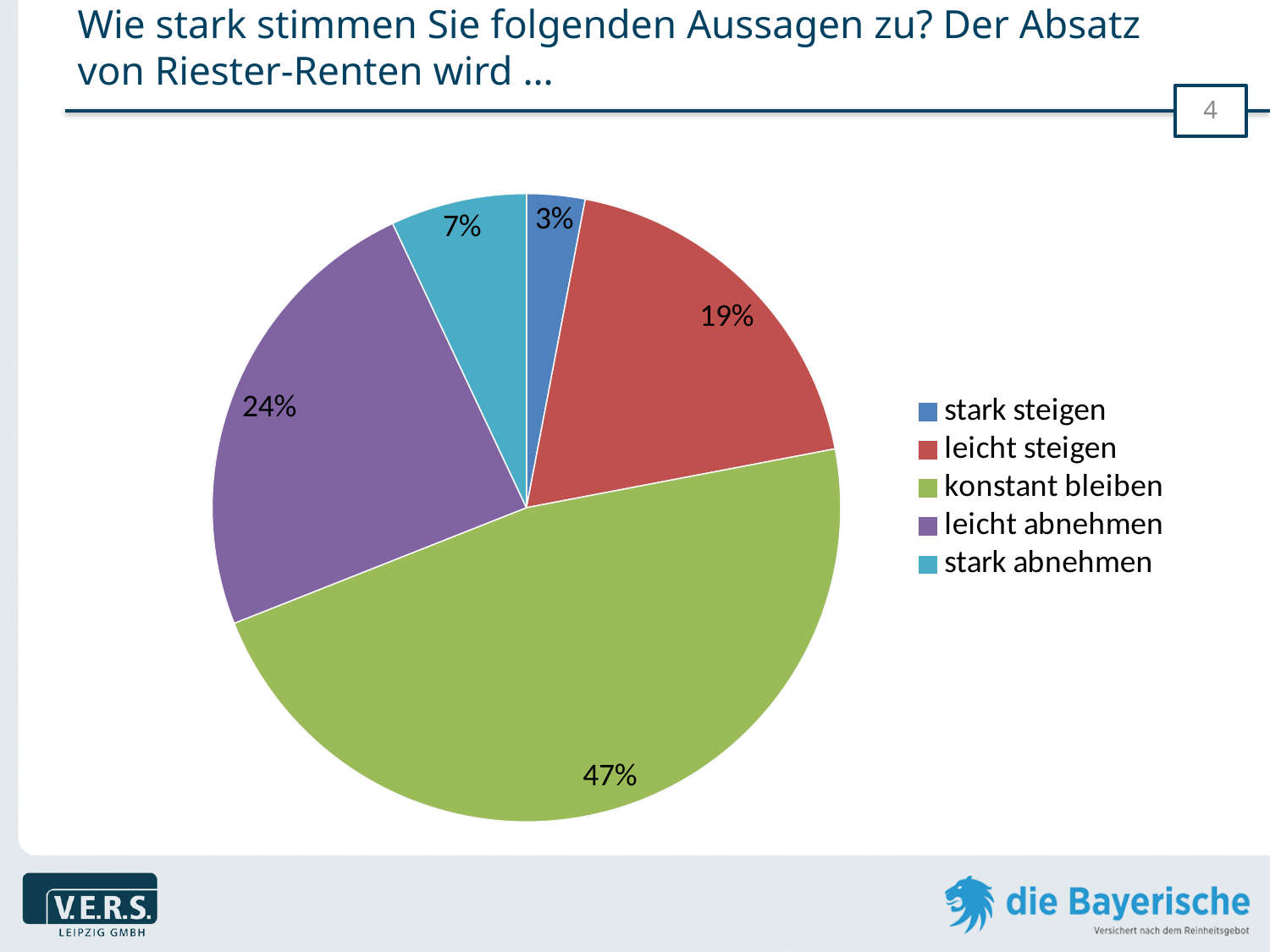
What is the value for "stark abnehmen"? 7% Which category has the smallest slice? stark steigen Which category has the largest slice? konstant bleiben What share of the pie does "konstant bleiben" have? 47% What is the value for "leicht steigen"? 19% What colour is the slice for "konstant bleiben"? green What is the value for "leicht abnehmen"? 24% What kind of chart is shown on the slide? pie chart How many categories does the pie chart have? 5 Which is larger, "leicht steigen" or "stark abnehmen"? leicht steigen What is the value for "stark steigen"? 3% What is the difference between "leicht abnehmen" and "leicht steigen"? 5%